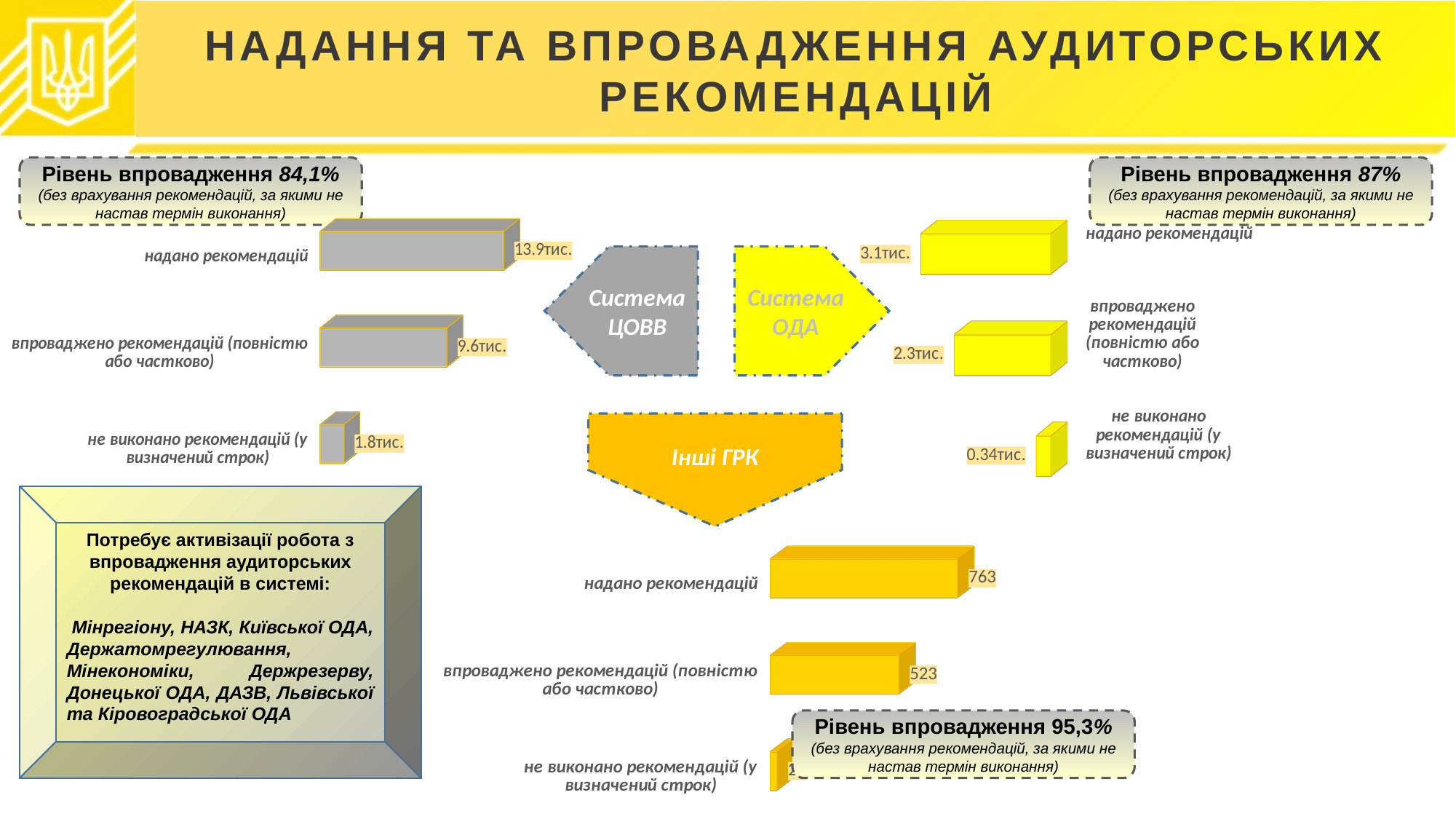
In the Система ОДА chart, what is the value for 'не виконано рекомендацій (у визначений строк)'? 0.34тис. In the Інші ГРК chart, what is the value for 'впроваджено рекомендацій (повністю або частково)'? 523 In the Система ОДА chart, which category has the lowest value? не виконано рекомендацій (у визначений строк) Which is larger: 'надано рекомендацій' in the Система ЦОВВ chart or 'надано рекомендацій' in the Система ОДА chart? Система ЦОВВ In the Система ЦОВВ chart, what is the value for 'надано рекомендацій'? 13.9тис. In the Система ЦОВВ chart, what is the value for 'не виконано рекомендацій (у визначений строк)'? 1.8тис. In the Система ЦОВВ chart, what is the value for 'впроваджено рекомендацій (повністю або частково)'? 9.6тис. In the Інші ГРК chart, what is the difference between 'надано рекомендацій' and 'впроваджено рекомендацій (повністю або частково)'? 240 In the Система ОДА chart, what is the value for 'надано рекомендацій'? 3.1тис. In the Інші ГРК chart, what is the value for 'надано рекомендацій'? 763 In the Система ЦОВВ chart, which category has the highest value? надано рекомендацій In the Система ЦОВВ chart, what is the difference between 'надано рекомендацій' and 'впроваджено рекомендацій (повністю або частково)'? 4.3тис.